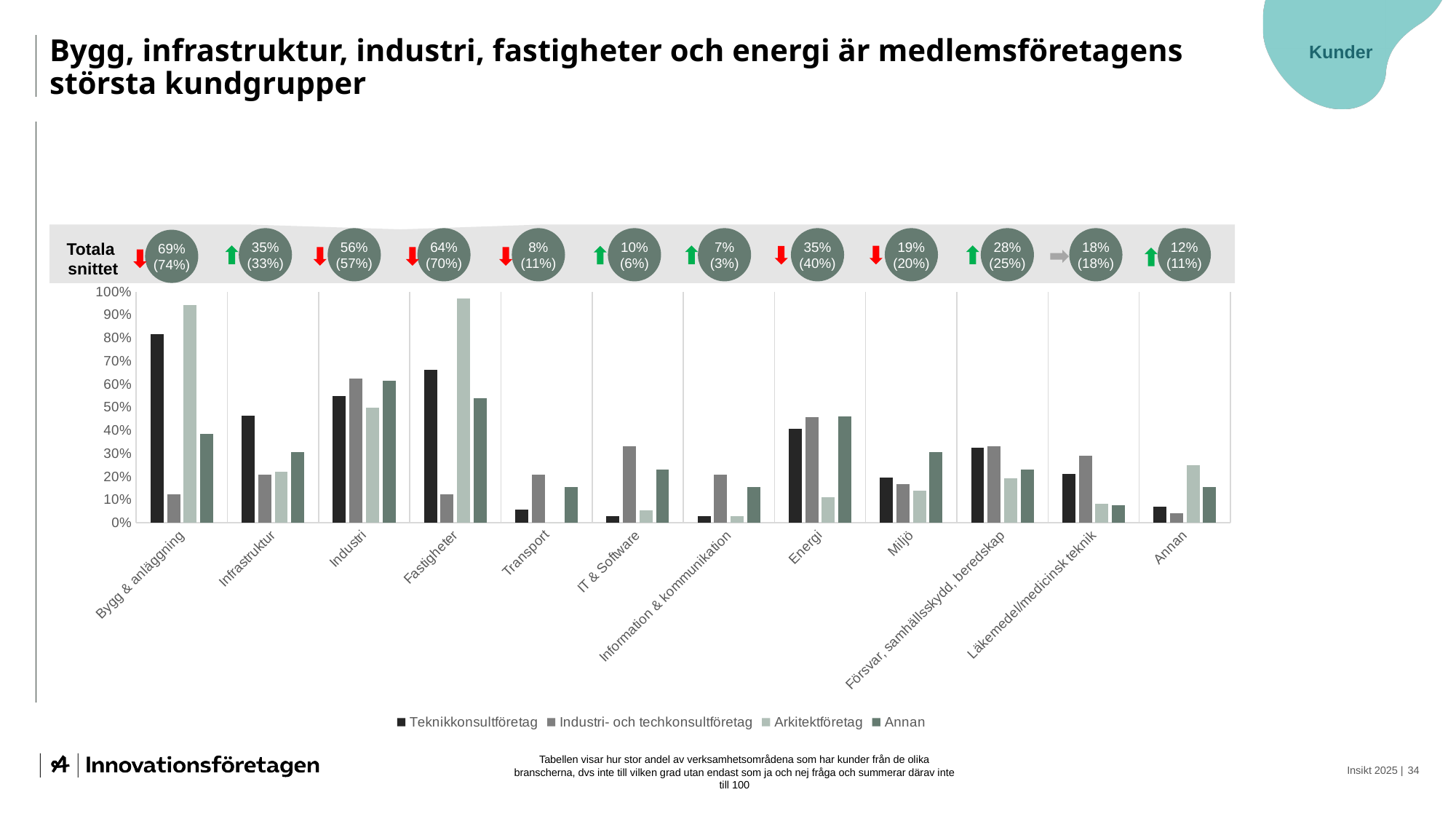
How many series does the chart legend list? 4 For Bygg & anläggning, which bar is taller: Teknikkonsultföretag or Arkitektföretag? Arkitektföretag Which category has the lowest 'Totala snittet' value? Information & kommunikation What is the value in parentheses shown in the 'Totala snittet' circle above Fastigheter? 70% Is the Annan bar for Transport greater or less than 20%? less Which category has the highest 'Totala snittet' value? Bygg & anläggning What kind of chart is shown on the slide? Bar chart What is the 'Totala snittet' value shown above Energi? 35% What is the 'Totala snittet' value shown above Bygg & anläggning? 69% What is the difference between the 'Totala snittet' values for Bygg & anläggning (69%) and Infrastruktur (35%)? 34 percentage points Is the Arkitektföretag bar for Fastigheter greater or less than 90%? greater How many customer categories are shown along the x axis of the chart? 12